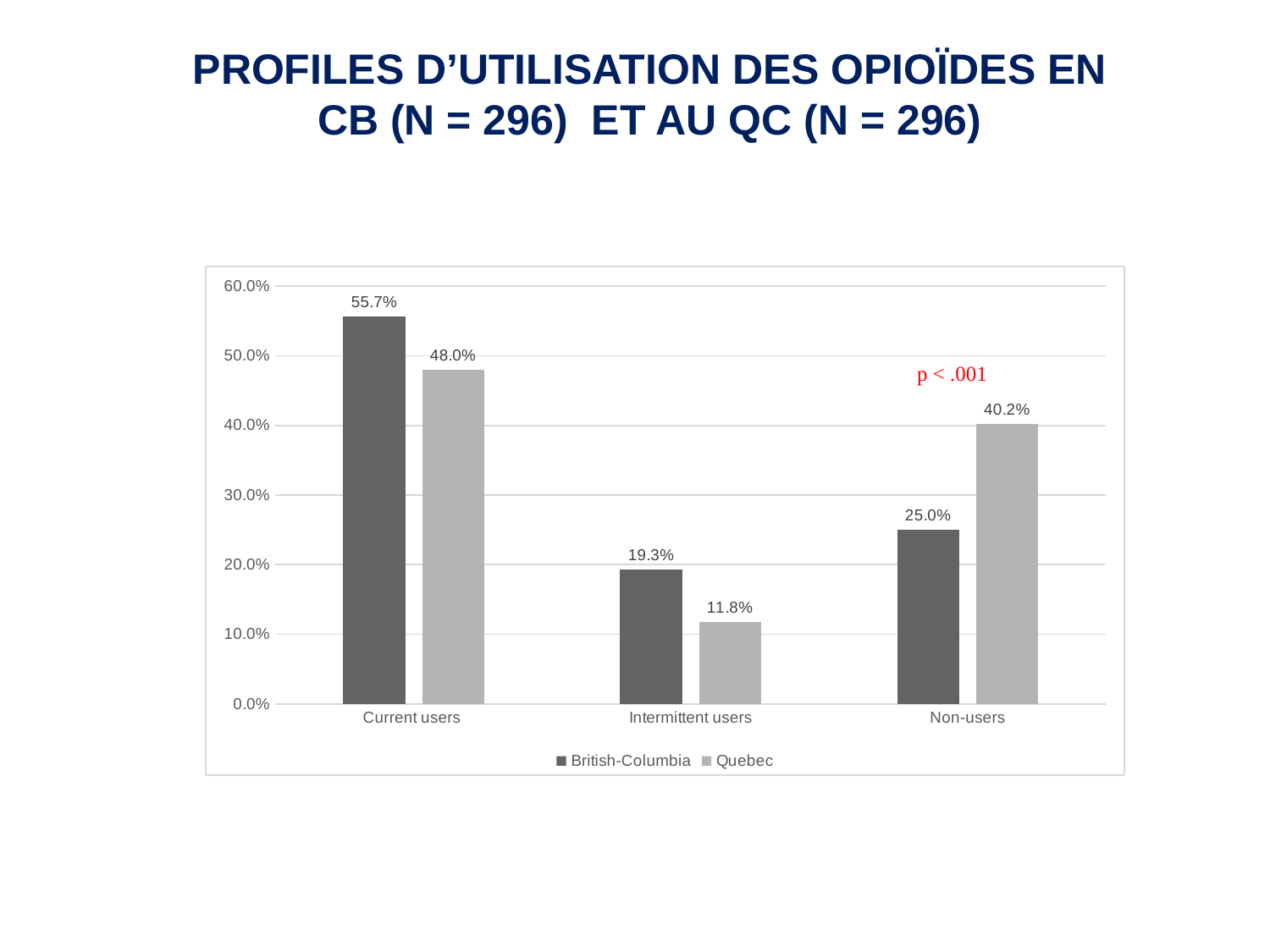
How many series does the legend list? 2 How many categories are shown on the x axis? 3 Which category has the lowest value for Quebec? Intermittent users Which category has the highest value for British-Columbia? Current users What is the difference between British-Columbia and Quebec among Current users? 7.7% What is the value for Quebec among Intermittent users? 11.8% What p-value annotation is shown on the chart? p < .001 What is the value for British-Columbia among Current users? 55.7% Which is larger among Intermittent users, British-Columbia or Quebec? British-Columbia What kind of chart is shown on the slide? Bar chart What is the value for Quebec among Non-users? 40.2% What is the difference between Quebec and British-Columbia among Non-users? 15.2%